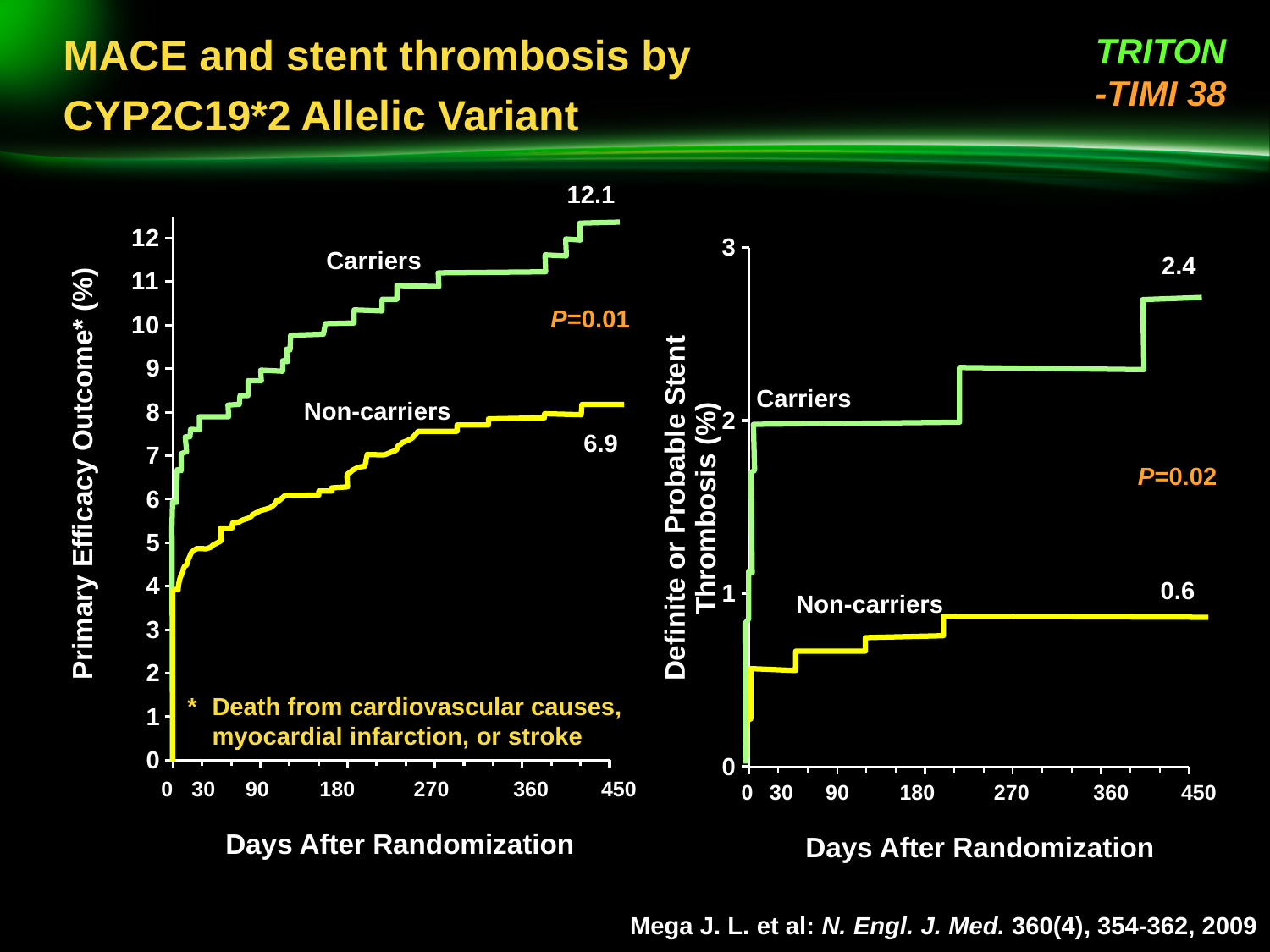
What P value is shown on the right chart (Definite or Probable Stent Thrombosis)? P=0.02 In the left chart (Primary Efficacy Outcome), what is the final value labelled for Carriers? 12.1 In the left chart (Primary Efficacy Outcome), which group has the higher final value, Carriers or Non-carriers? Carriers In the right chart (Definite or Probable Stent Thrombosis), what is the difference between the final Carriers and Non-carriers values? 1.8 In the left chart (Primary Efficacy Outcome), what is the difference between the final Carriers and Non-carriers values? 5.2 In the left chart (Primary Efficacy Outcome), what is the final value labelled for Non-carriers? 6.9 In the right chart (Definite or Probable Stent Thrombosis), what is the final value labelled for Carriers? 2.4 In the right chart (Definite or Probable Stent Thrombosis), which group has the lower final value? Non-carriers In the left chart (Primary Efficacy Outcome), do the values for Carriers rise or fall as days after randomization increase? Rise In the right chart (Definite or Probable Stent Thrombosis), what is the final value labelled for Non-carriers? 0.6 In the right chart (Definite or Probable Stent Thrombosis), is the final value for Non-carriers greater or less than 1? less What kind of chart is the left chart (Primary Efficacy Outcome)? Line chart